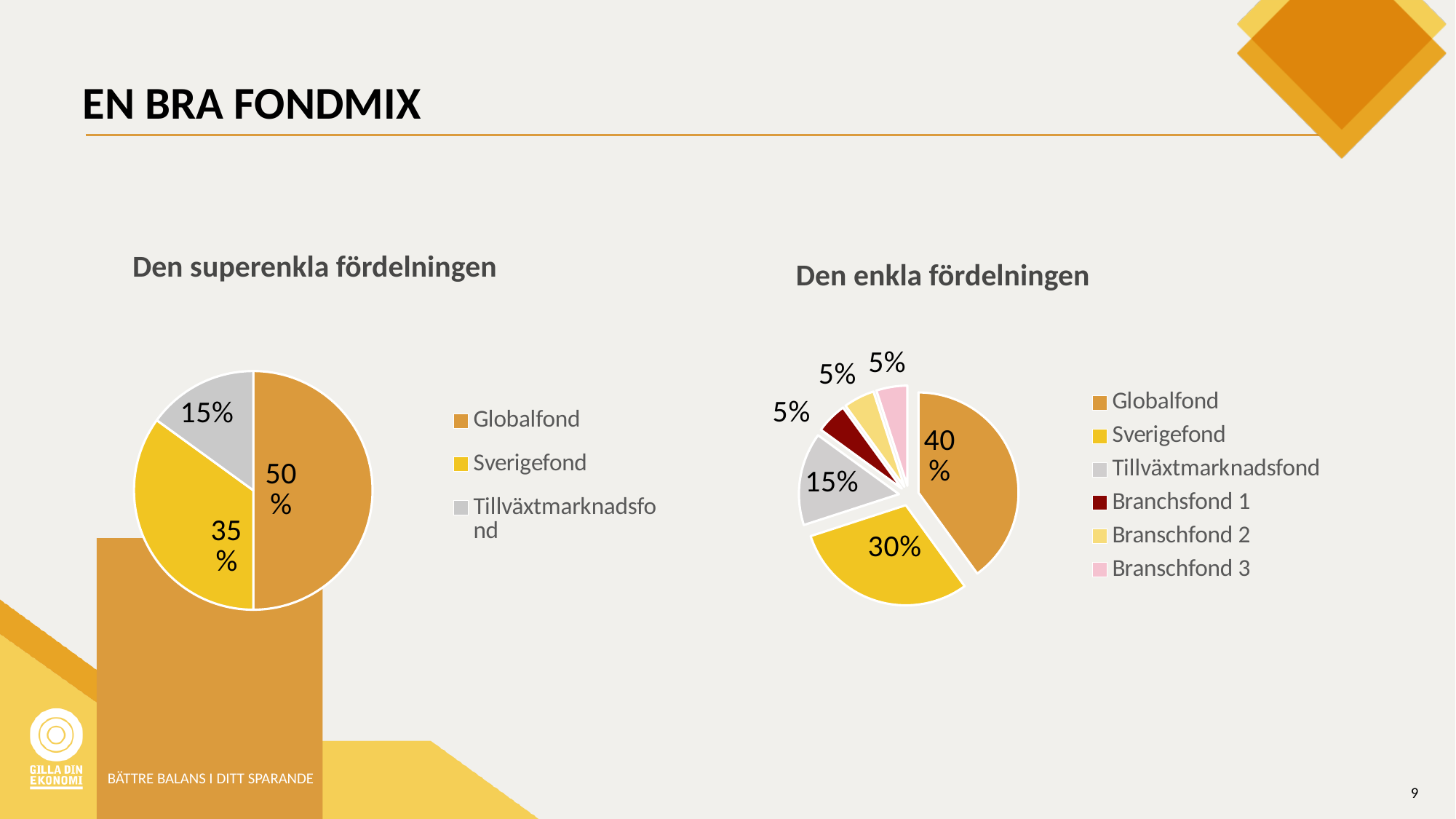
In the 'Den enkla fördelningen' chart, what share does Tillväxtmarknadsfond have? 15% In the 'Den enkla fördelningen' chart, which is larger: Sverigefond or Tillväxtmarknadsfond? Sverigefond What kind of chart is 'Den enkla fördelningen'? Pie chart In the 'Den superenkla fördelningen' chart, what share does Globalfond have? 50% In the 'Den superenkla fördelningen' chart, how many slices does the pie have? 3 In the 'Den enkla fördelningen' chart, what share does Globalfond have? 40% In the 'Den enkla fördelningen' chart, what colour is the Branchsfond 1 slice? Dark red In the 'Den superenkla fördelningen' chart, which category has the smallest share? Tillväxtmarknadsfond In the 'Den enkla fördelningen' chart, how many categories does the legend list? 6 In the 'Den superenkla fördelningen' chart, what share does Sverigefond have? 35% In the 'Den enkla fördelningen' chart, which category has the largest share? Globalfond In the 'Den superenkla fördelningen' chart, what is the difference between the Globalfond and Sverigefond shares? 15%